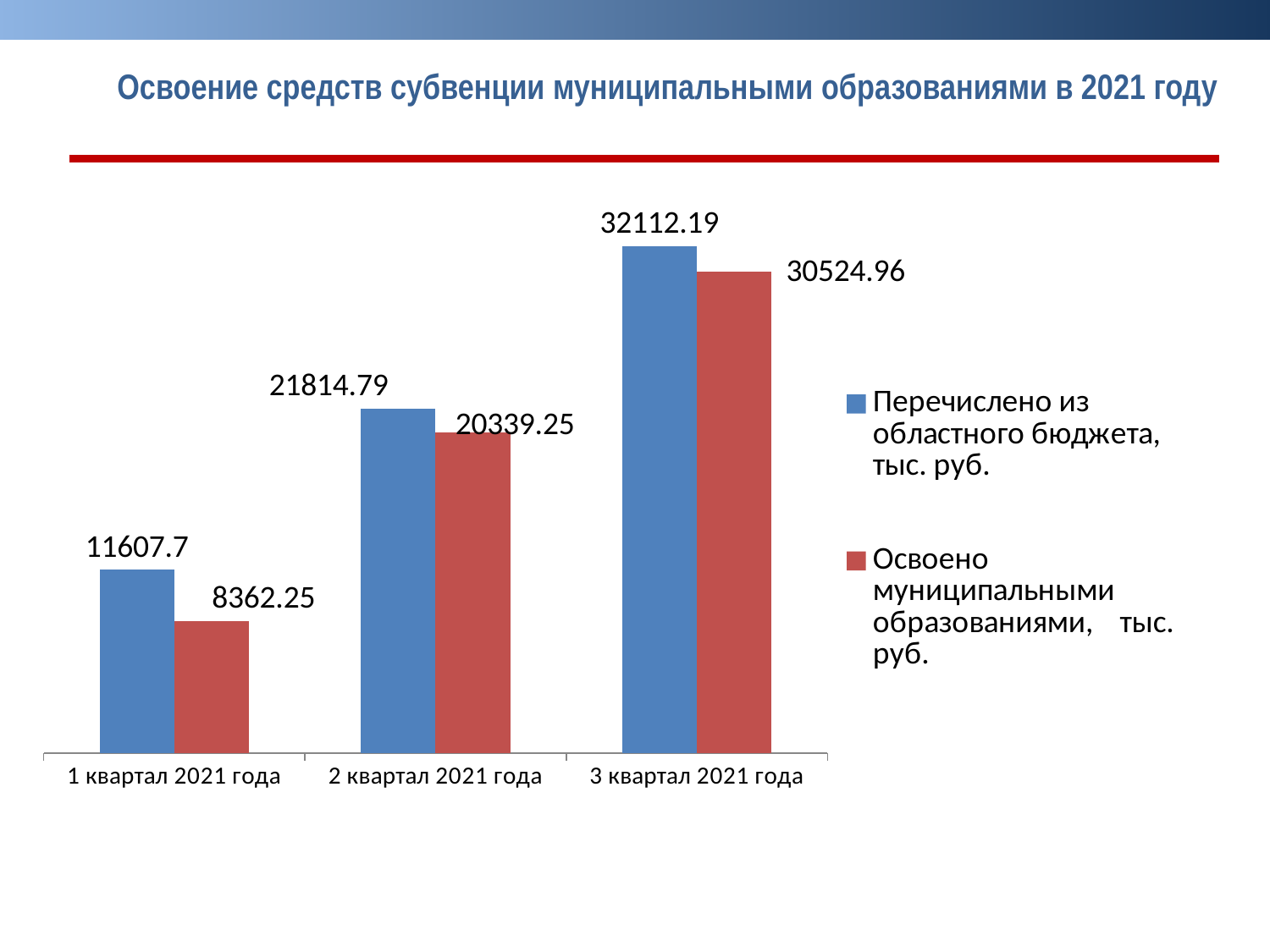
What is the difference between 'Перечислено из областного бюджета' and 'Освоено муниципальными образованиями' for '3 квартал 2021 года'? 1587.23 What kind of chart is shown on the slide? Bar chart What is the difference between 'Перечислено из областного бюджета' and 'Освоено муниципальными образованиями' for '1 квартал 2021 года'? 3245.45 In which quarter is 'Перечислено из областного бюджета, тыс. руб.' highest? 3 квартал 2021 года How many quarters are shown on the x axis? 3 In which quarter is 'Освоено муниципальными образованиями, тыс. руб.' lowest? 1 квартал 2021 года What is the value of 'Освоено муниципальными образованиями, тыс. руб.' for '2 квартал 2021 года'? 20339.25 Do the values of 'Освоено муниципальными образованиями, тыс. руб.' rise or fall from the 1st to the 3rd quarter? Rise What is the value of 'Освоено муниципальными образованиями, тыс. руб.' for '3 квартал 2021 года'? 30524.96 What is the value of 'Перечислено из областного бюджета, тыс. руб.' for '1 квартал 2021 года'? 11607.7 Which is larger for '2 квартал 2021 года': 'Перечислено из областного бюджета' or 'Освоено муниципальными образованиями'? Перечислено из областного бюджета How many series does the legend list? 2